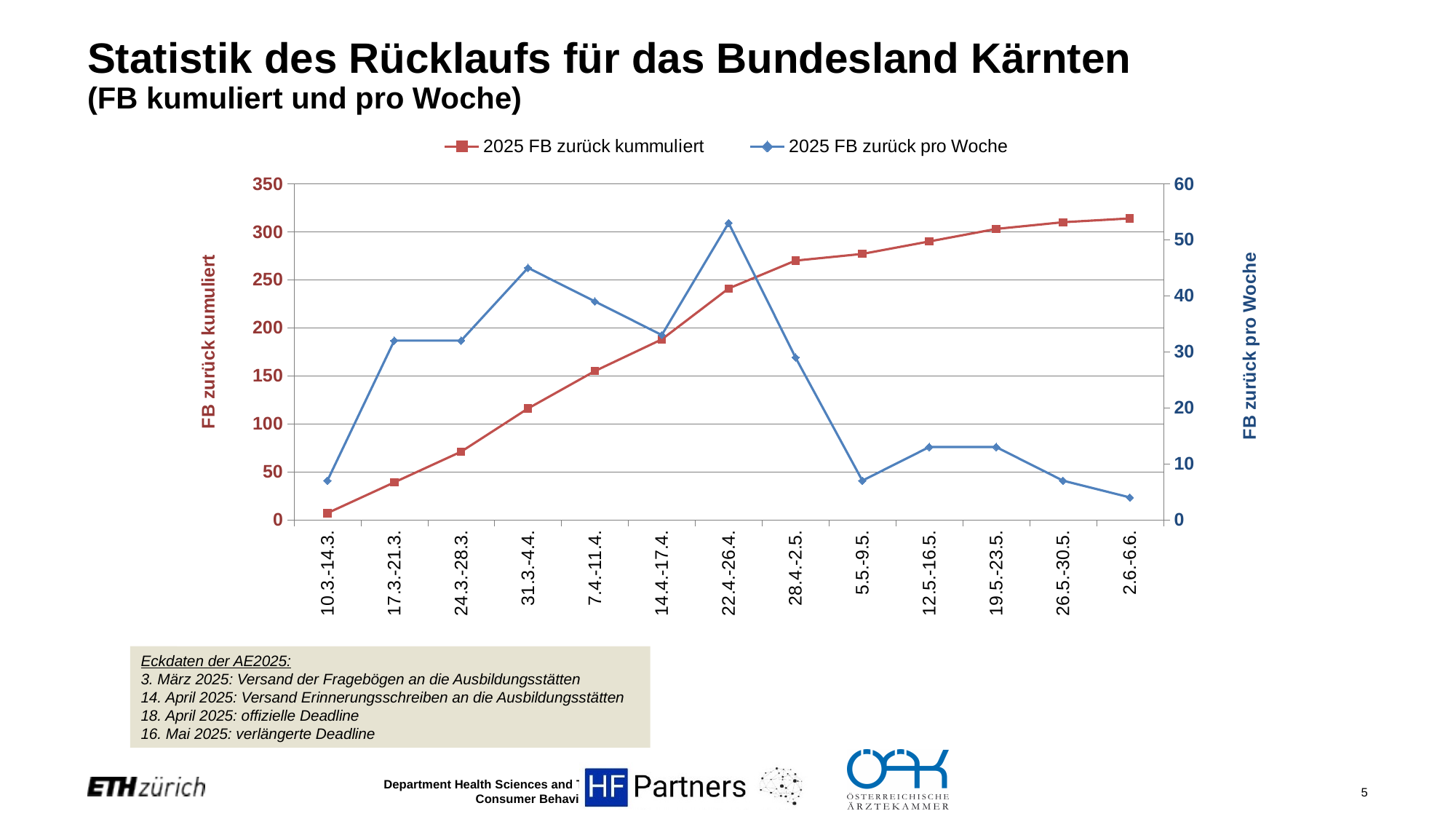
In which week period is the value for '2025 FB zurück pro Woche' highest? 22.4.-26.4. In which week period is the value for '2025 FB zurück kummuliert' highest? 2.6.-6.6. Does the '2025 FB zurück kummuliert' series rise or fall along the x axis? Rises Is the value for '2025 FB zurück pro Woche' in the week 5.5.-9.5. greater or less than 10? less What is the title of the right-hand vertical axis? FB zurück pro Woche In which week period is the value for '2025 FB zurück pro Woche' lowest? 2.6.-6.6. How many week periods are shown on the x axis? 13 Is the value for '2025 FB zurück kummuliert' in the week 22.4.-26.4. greater or less than 200? greater How many series does the legend list? 2 For '2025 FB zurück pro Woche', which week has the larger value: 31.3.-4.4. or 7.4.-11.4.? 31.3.-4.4. What kind of chart is shown on the slide? Line chart Is the value for '2025 FB zurück kummuliert' in the week 2.6.-6.6. greater or less than 300? greater